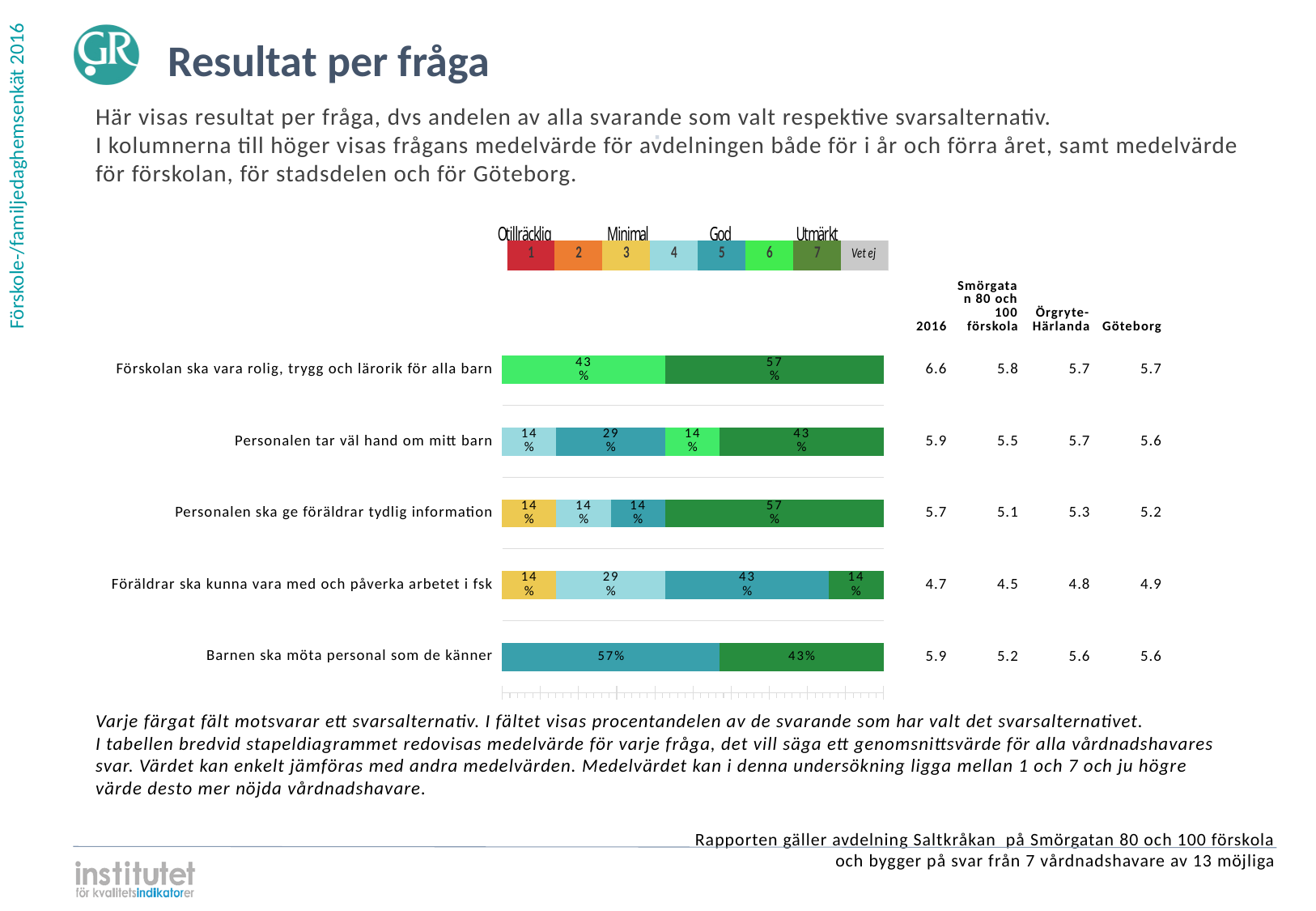
Which question has the smallest share of answer 7 (dark green)? Föräldrar ska kunna vara med och påverka arbetet i fsk What type of chart is shown on the slide? Stacked bar chart Which is larger for 'Personalen tar väl hand om mitt barn': the share of answer 7 or the share of answer 5? Answer 7 How many questions (categories) are plotted in the bar chart? 5 What percentage of respondents chose answer 5 for 'Personalen tar väl hand om mitt barn'? 29% How many answer alternatives does the legend above the chart list? 8 What percentage of respondents chose answer 7 (dark green) for 'Föräldrar ska kunna vara med och påverka arbetet i fsk'? 14% What is the difference between the answer 7 share and the answer 6 share for 'Förskolan ska vara rolig, trygg och lärorik för alla barn'? 14% What percentage of respondents chose answer 6 (light green) for 'Förskolan ska vara rolig, trygg och lärorik för alla barn'? 43% What label does the legend give to the grey box at the right end of the scale? Vet ej What percentage of respondents chose answer 5 for 'Barnen ska möta personal som de känner'? 57% What percentage of respondents chose answer 7 (dark green) for 'Förskolan ska vara rolig, trygg och lärorik för alla barn'? 57%